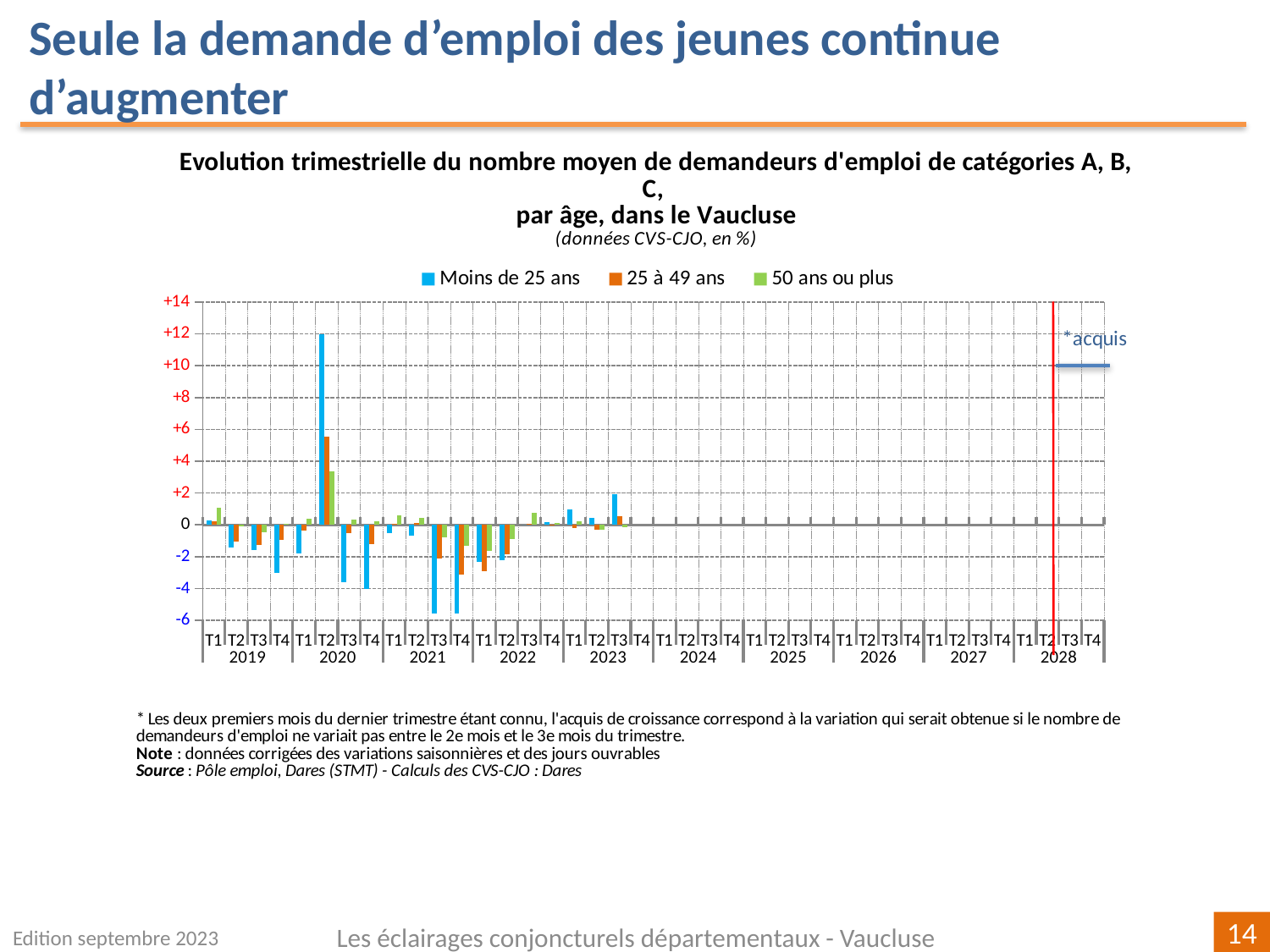
Is the value for 'Moins de 25 ans' in T3 2021 greater or less than -4? less Is the value for 'Moins de 25 ans' in T2 2020 greater or less than +10? greater How many years are labelled along the x axis? 10 What kind of chart is shown on the slide? bar chart How many series does the legend list? 3 What are the three series listed in the legend? Moins de 25 ans, 25 à 49 ans, 50 ans ou plus Is the value for '25 à 49 ans' in T2 2020 greater or less than +4? greater In which quarter does the 'Moins de 25 ans' series reach its highest value? T2 2020 In T2 2020, which series has the larger value: 'Moins de 25 ans' or '25 à 49 ans'? Moins de 25 ans What is the highest value shown on the y axis? +14 Which colour represents the 'Moins de 25 ans' series? blue